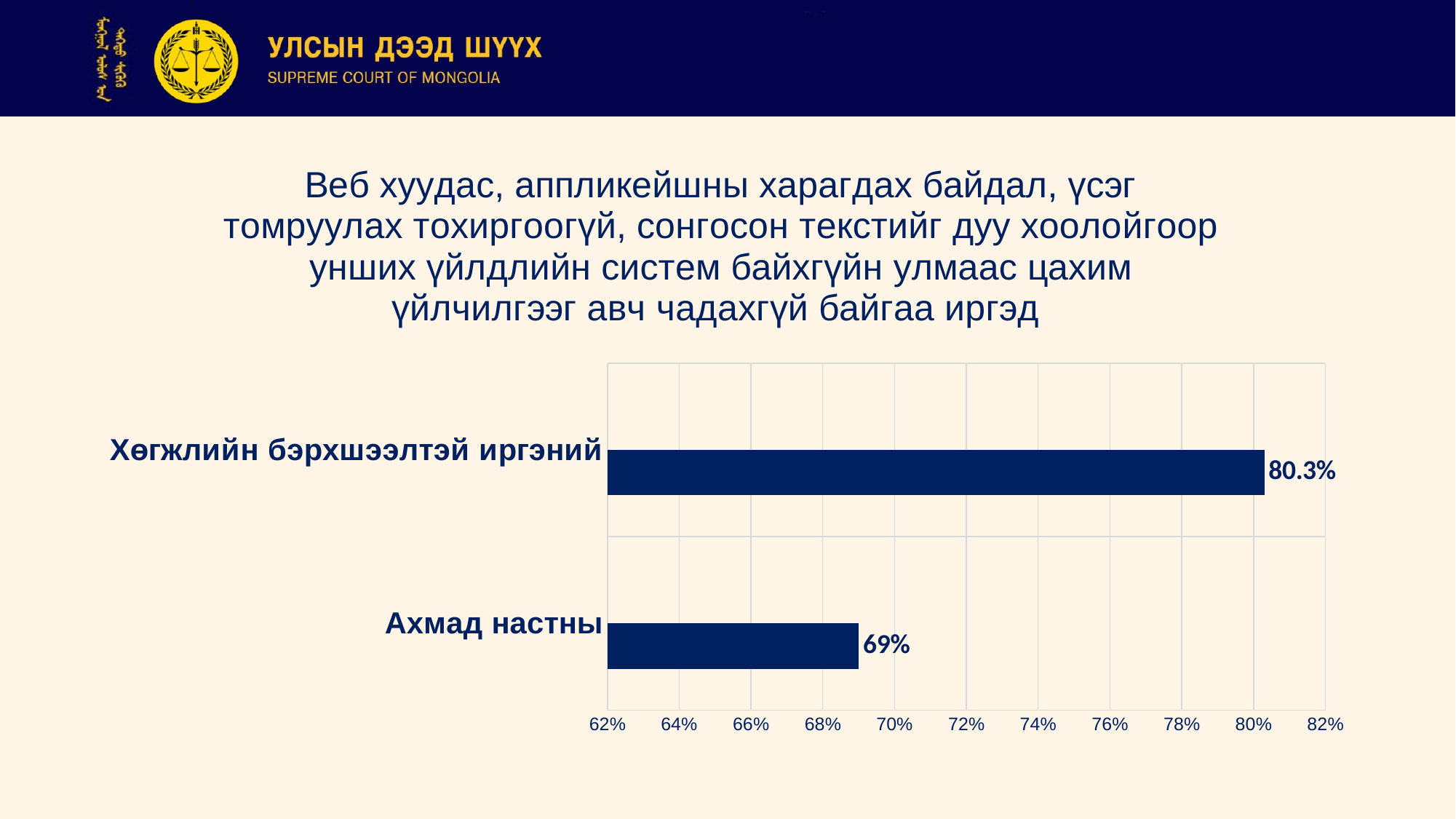
Which category has the highest value? Хөгжлийн бэрхшээлтэй иргэний What is the difference between the values for Хөгжлийн бэрхшээлтэй иргэний and Ахмад настны? 11.3% What is the lowest value shown on the x axis of the chart? 62% Which category has the lowest value? Ахмад настны What is the highest value shown on the x axis of the chart? 82% Which is larger, the value for Ахмад настны or the value for Хөгжлийн бэрхшээлтэй иргэний? Хөгжлийн бэрхшээлтэй иргэний Is the value for Хөгжлийн бэрхшээлтэй иргэний greater or less than 78%? greater Is the value for Ахмад настны greater or less than 70%? less How many categories are shown in the chart? 2 What is the value for Хөгжлийн бэрхшээлтэй иргэний? 80.3% What kind of chart is shown on the slide? bar chart What is the value for Ахмад настны? 69%